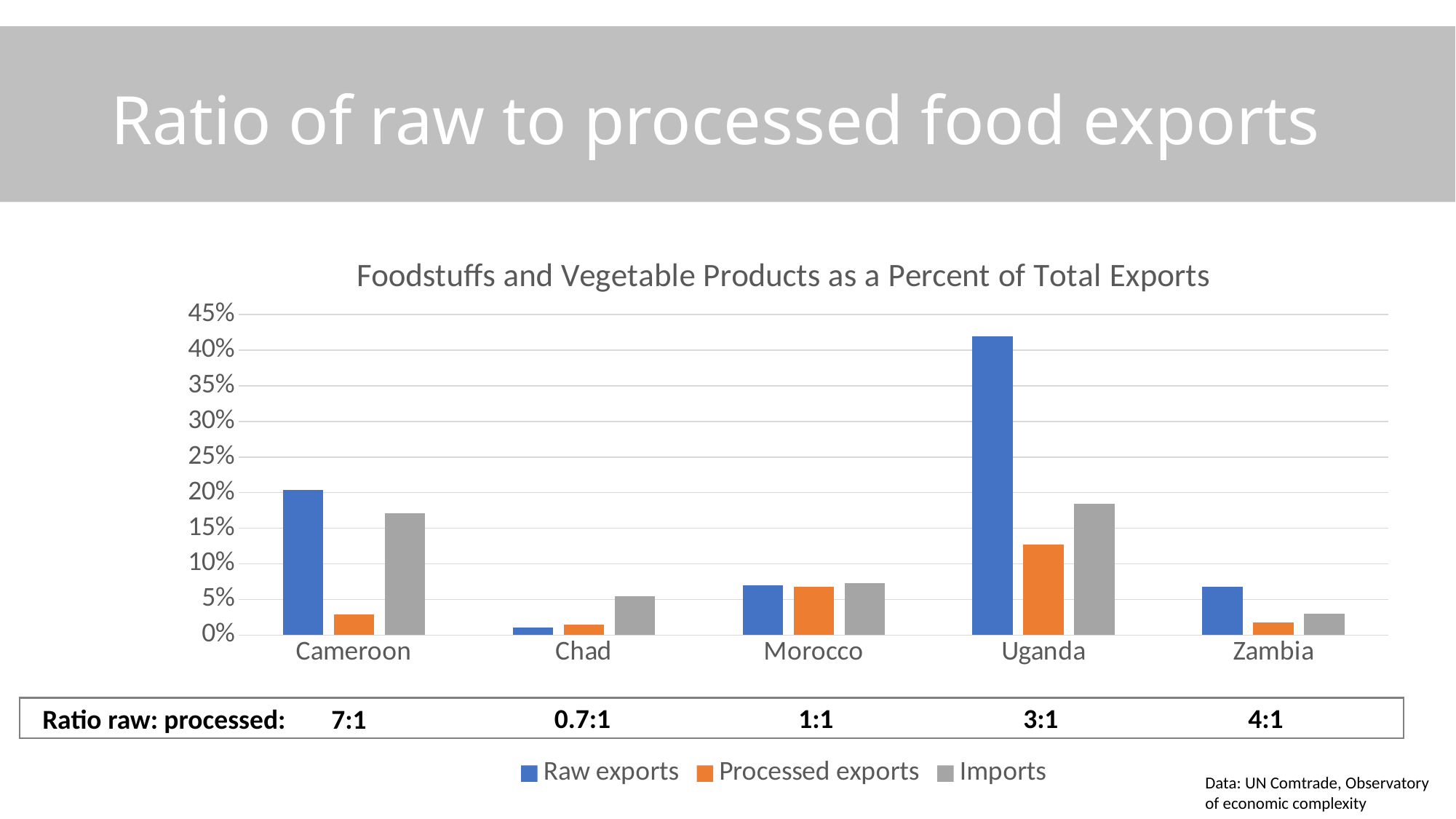
Is the Processed exports value for Uganda greater or less than 10%? greater Is the Raw exports value for Uganda greater or less than 40%? greater What kind of chart is shown on the slide? bar chart How many series does the legend list? 3 Which country has the highest Imports value? Uganda For Cameroon, which is larger: Raw exports or Imports? Raw exports Is the Raw exports value for Cameroon greater or less than 15%? greater What is the title of the chart? Foodstuffs and Vegetable Products as a Percent of Total Exports How many countries are shown on the x axis? 5 Which country has the lowest Raw exports value? Chad Which country has the highest Raw exports value? Uganda